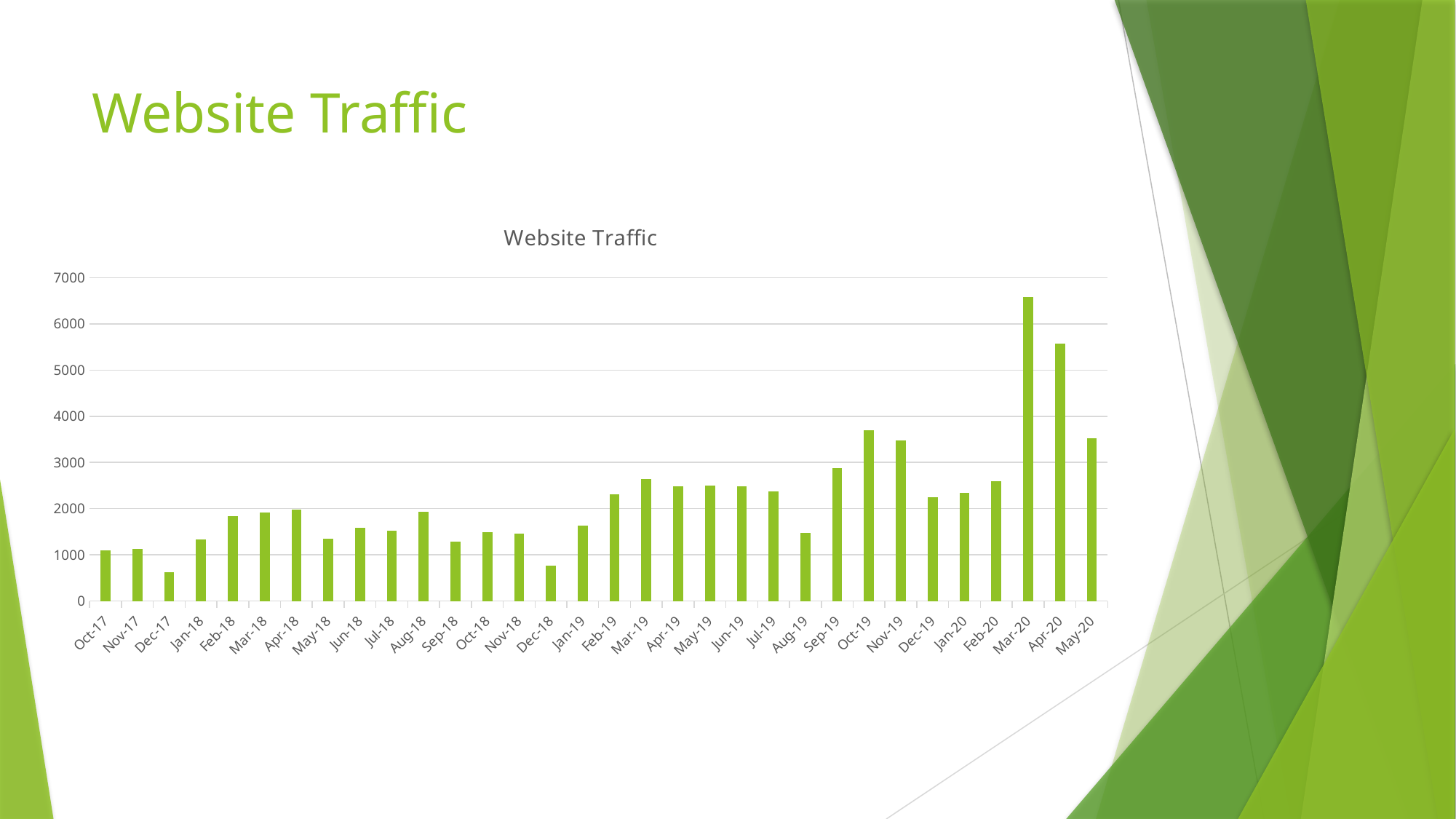
What kind of chart is shown on the slide? bar chart Which month has the lowest website traffic? Dec-17 How many months are plotted on the chart? 32 Which is larger, the value for Mar-20 or the value for Apr-20? Mar-20 What is the title of the chart? Website Traffic Which month has the highest website traffic? Mar-20 Is the value for Oct-19 greater or less than 3000? greater Which is larger, the value for Oct-19 or the value for Dec-19? Oct-19 Is the value for Mar-20 greater or less than 6000? greater Is the value for Apr-20 greater or less than 5000? greater Overall, does website traffic rise or fall from Oct-17 to May-20? rise